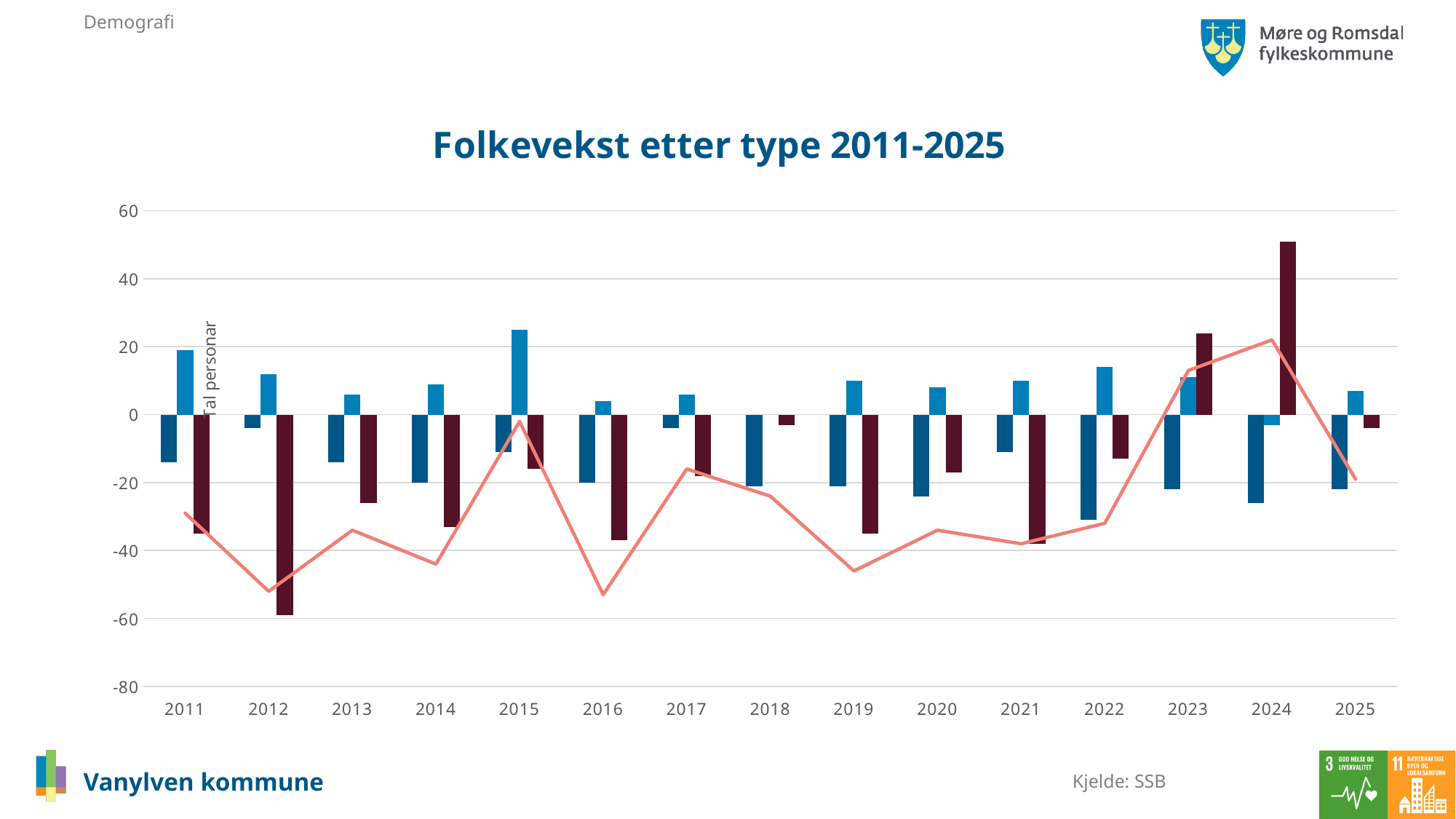
Is the salmon-coloured series in the chart drawn as bars or as a line? a line In which year does the salmon line reach its highest value? 2024 Does the salmon line rise or fall from 2021 to 2024? rise Is the dark red bar for 2024 greater or less than 40? greater In which year does the dark red bar reach its lowest value? 2012 Which is larger, the light blue bar for 2015 or the light blue bar for 2011? 2015 What is the title of the chart? Folkevekst etter type 2011-2025 In which year is the light blue bar tallest? 2015 Is the dark red bar for 2012 greater or less than -40? less How many years are shown on the x axis of the chart? 15 Is the salmon line value for 2016 greater or less than -40? less In which year does the dark red bar reach its highest value? 2024